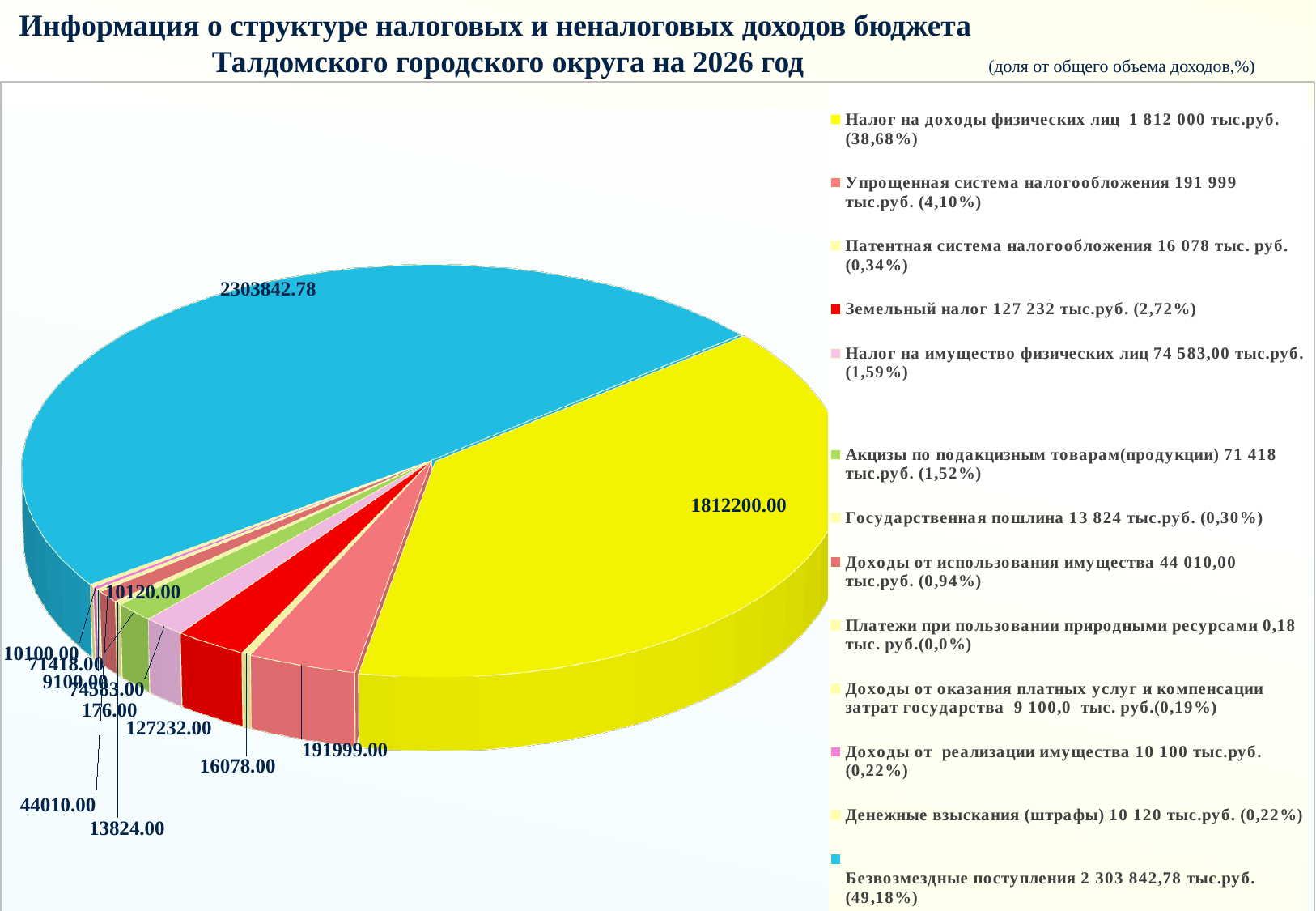
What kind of chart is shown on the slide? pie chart According to the legend, what share of total revenue do Безвозмездные поступления make up? 49,18% What data label is shown on the slice for Земельный налог? 127232.00 What data label is shown on the slice for Упрощенная система налогообложения? 191999.00 What colour is the largest slice of the pie? blue Which category has the largest slice of the pie? Безвозмездные поступления What is the difference between the data labels for Безвозмездные поступления (2303842.78) and Налог на доходы физических лиц (1812200.00)? 491642.78 Which slice is larger: Земельный налог or Упрощенная система налогообложения? Упрощенная система налогообложения According to the legend, what share of total revenue does Земельный налог make up? 2,72% How many categories does the legend of the pie chart list? 13 What data label is shown on the slice for Безвозмездные поступления? 2303842.78 Which category has the smallest slice of the pie? Платежи при пользовании природными ресурсами